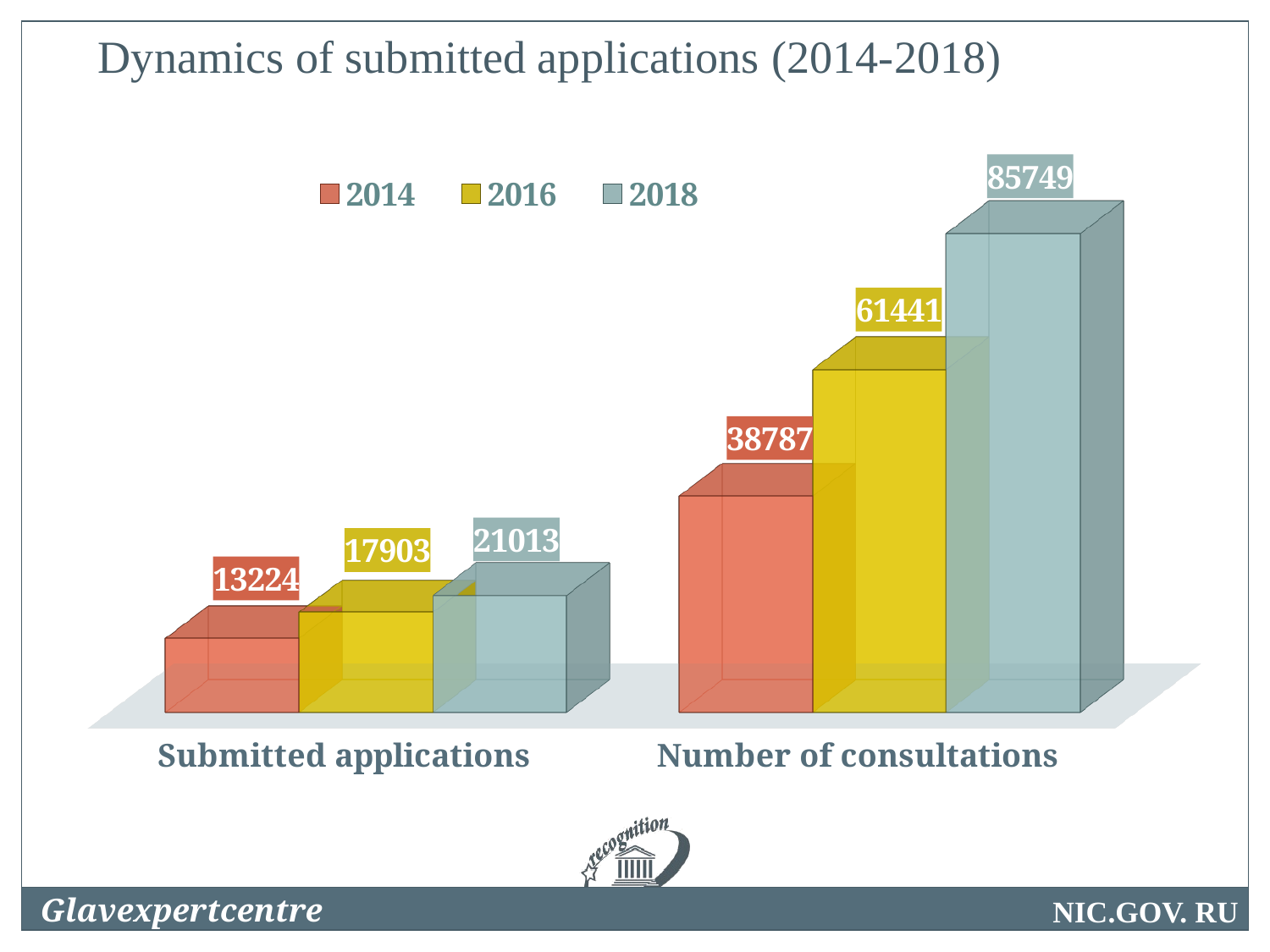
Which year has the lowest value for Submitted applications? 2014 What is the value for 2014 in the Submitted applications category? 13224 What is the title of the chart? Dynamics of submitted applications (2014-2018) What is the value for 2018 in the Number of consultations category? 85749 What is the difference between the 2018 and 2016 values for Number of consultations? 24308 How many categories are shown on the x axis? 2 What is the difference between the 2018 and 2014 values for Submitted applications? 7789 Which year has the highest value for Number of consultations? 2018 What is the value for 2016 in the Number of consultations category? 61441 What kind of chart is shown on the slide? Bar chart How many series does the legend list? 3 Which is larger: the 2016 value for Submitted applications or the 2014 value for Number of consultations? 2014 value for Number of consultations